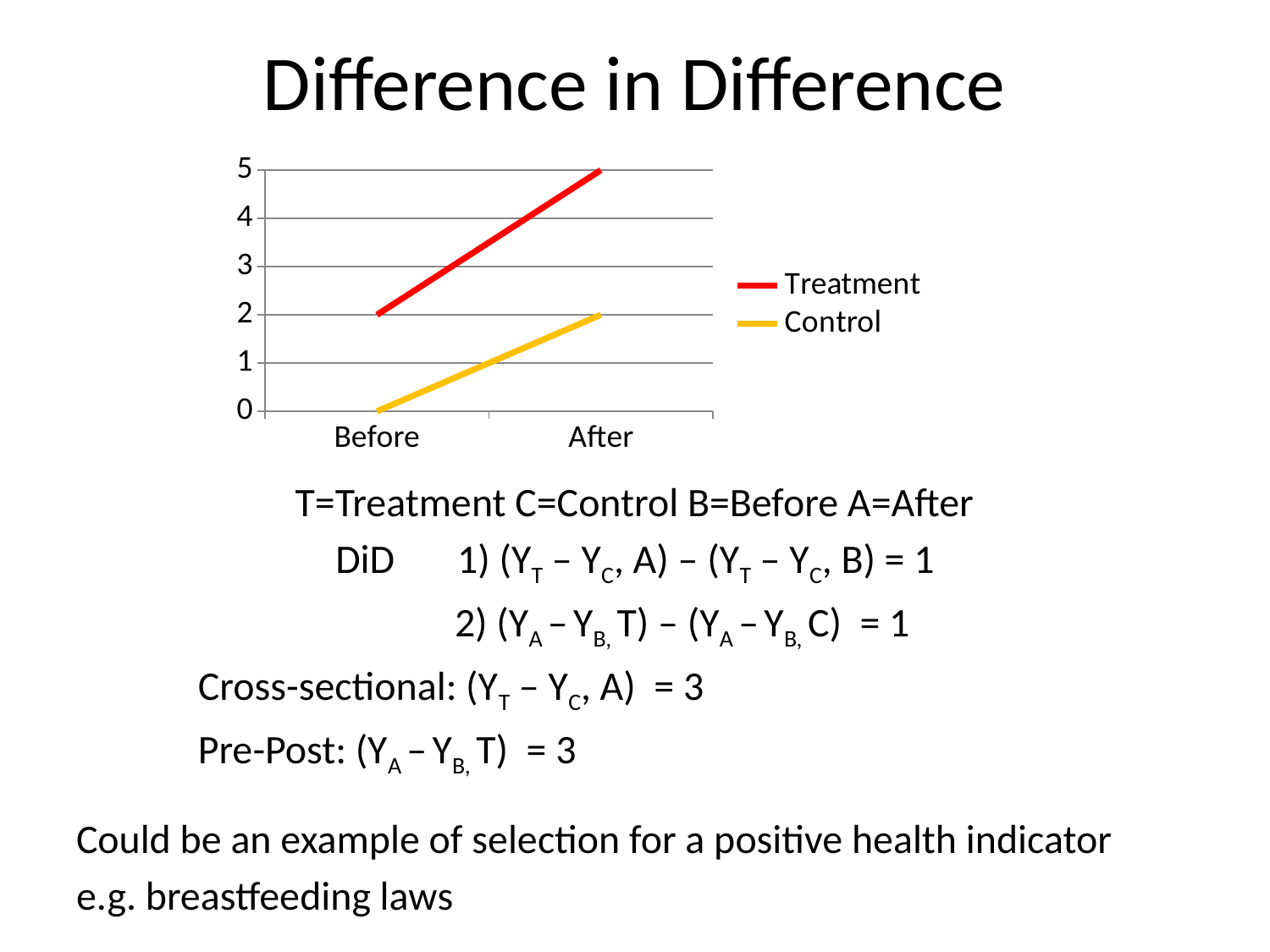
How many series does the chart legend list? 2 What colour is the Treatment line in the chart? red What are the two series named in the chart legend? Treatment and Control Which series has the higher value at After? Treatment What is the value of the Control series at After? 2 What is the value of the Treatment series at After? 5 What is the value of the Control series at Before? 0 What is the value of the Treatment series at Before? 2 What kind of chart is shown on the slide? line chart How many categories are on the x axis of the chart? 2 What is the difference between the Treatment and Control values at After? 3 Does the Control series rise or fall from Before to After? rise